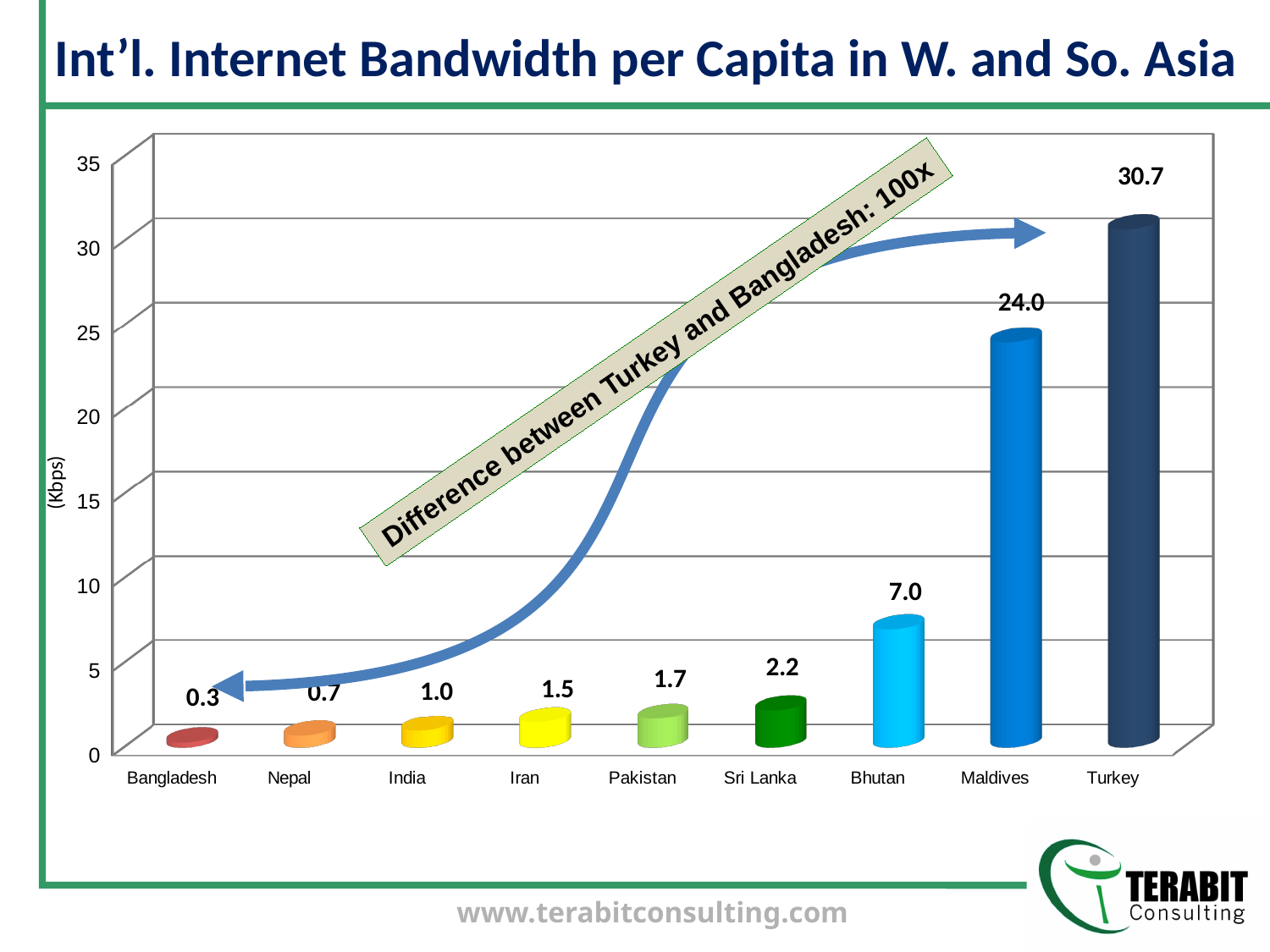
What is the international Internet bandwidth per capita for Maldives? 24.0 What unit is shown on the vertical axis label? Kbps Is the value for Maldives greater or less than 20? greater What is the difference between the values for Bhutan and Sri Lanka? 4.8 What is the value shown for Bhutan? 7.0 What is the value shown for Sri Lanka? 2.2 What kind of chart is shown on the slide? bar chart Which has a larger value, Pakistan or Iran? Pakistan Which country has the highest bandwidth per capita on the chart? Turkey Which country has the lowest bandwidth per capita on the chart? Bangladesh What is the difference between the values for Turkey and Maldives? 6.7 How many countries are shown on the chart? 9